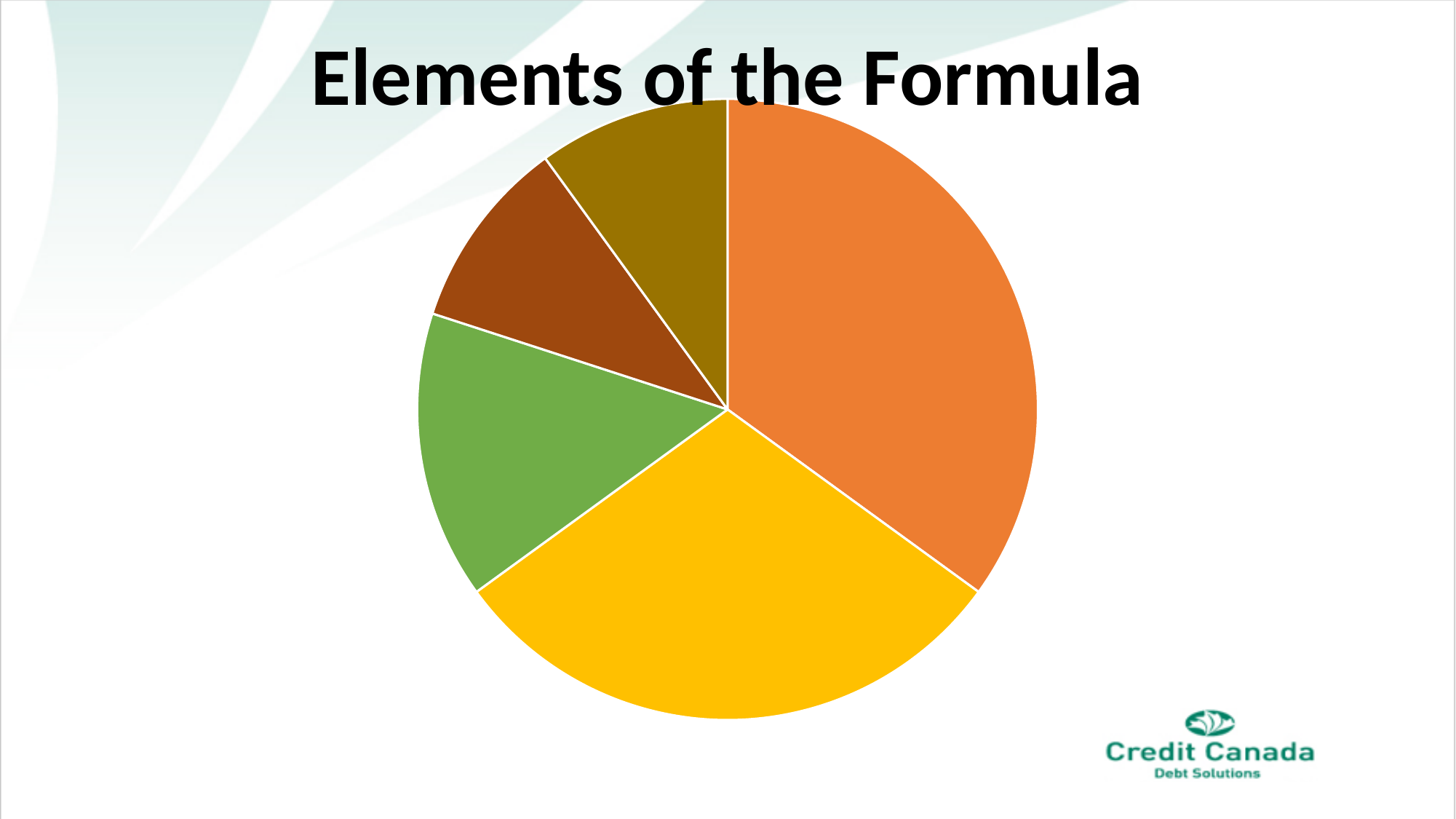
What kind of chart is shown on the slide? pie chart Which is larger in the pie chart, the yellow slice or the dark brown slice? the yellow slice Which is larger in the pie chart, the orange slice or the green slice? the orange slice What is the title of the slide containing the pie chart? Elements of the Formula How many slices does the pie chart have? 5 Does the pie chart have a legend? No Which colour slice is the largest in the pie chart? orange